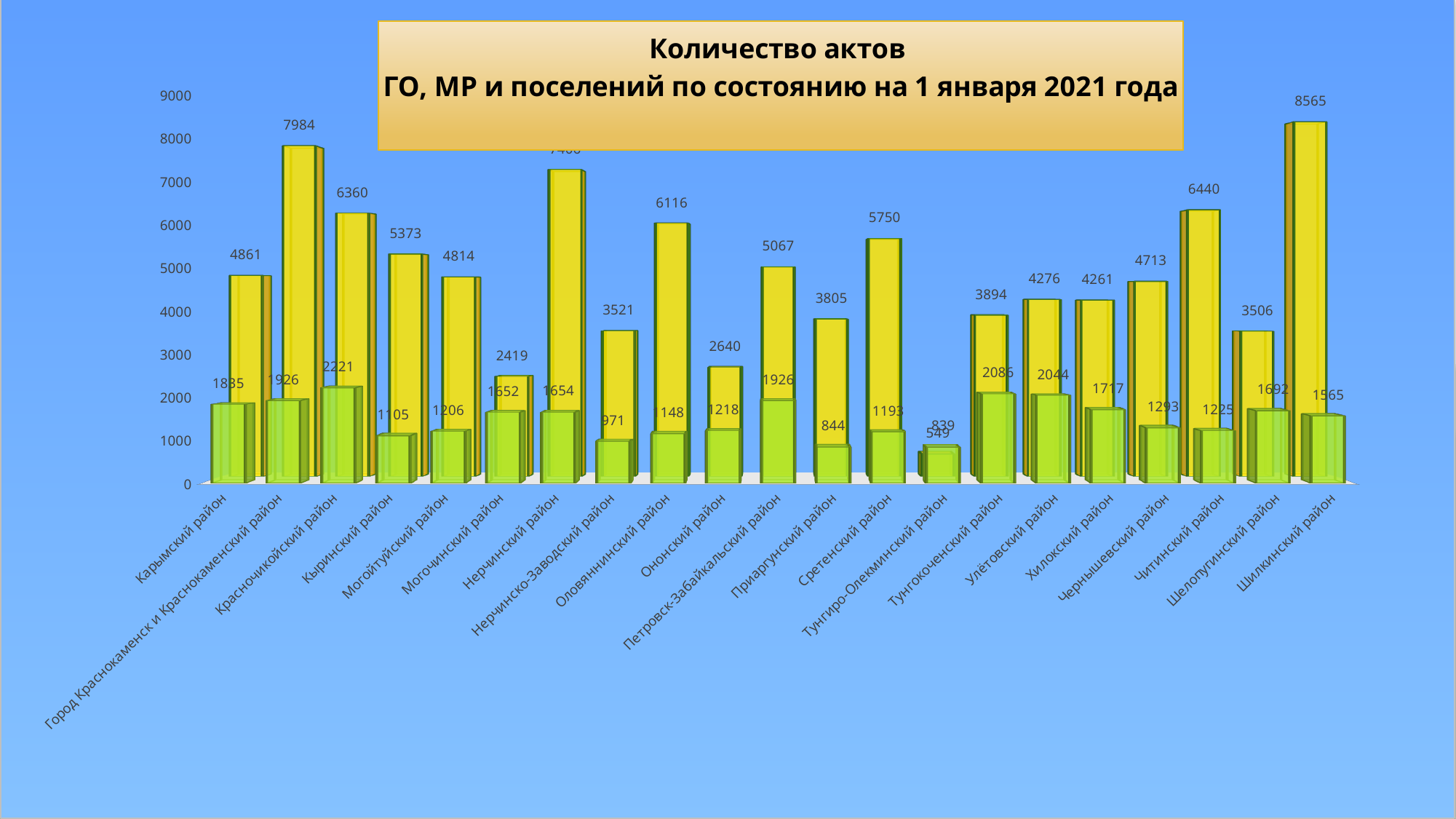
Which district has the lowest green bar? Тунгиро-Олекминский район What is the value of the yellow bar for Шилкинский район? 8565 How many districts are shown on the x axis? 21 Which district has the highest yellow bar? Шилкинский район Is the yellow bar for Город Краснокаменск и Краснокаменский район greater or less than 7000? greater What is the value of the green bar for Красночикойский район? 2221 What kind of chart is shown on the slide? bar chart What is the difference between the yellow bar and the green bar for Читинский район? 5215 What is the title of the chart? Количество актов ГО, МР и поселений по состоянию на 1 января 2021 года What is the value of the yellow bar for Сретенский район? 5750 Which is larger: the yellow bar for Оловяннинский район or the yellow bar for Красночикойский район? Красночикойский район What is the value of the green bar for Приаргунский район? 844